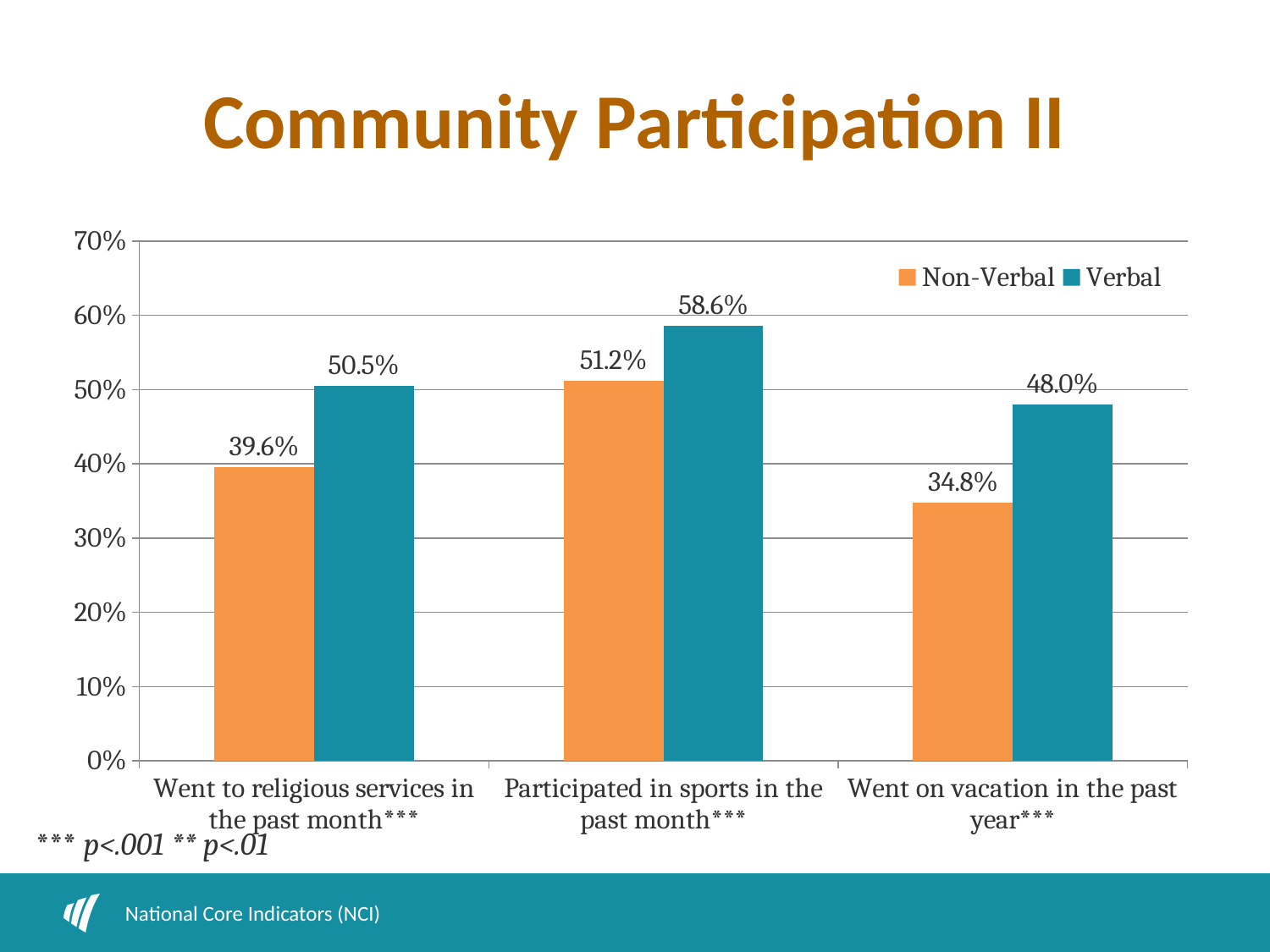
Which category has the highest Verbal value? Participated in sports in the past month What is the Verbal value for 'Participated in sports in the past month'? 58.6% Which is larger for 'Participated in sports in the past month': the Non-Verbal value or the Verbal value? Verbal Is the Non-Verbal value for 'Participated in sports in the past month' greater or less than 50%? greater What is the Verbal value for 'Went on vacation in the past year'? 48.0% What is the Non-Verbal value for 'Went on vacation in the past year'? 34.8% How many categories are shown on the x axis? 3 Which category has the lowest Non-Verbal value? Went on vacation in the past year What is the difference between the Verbal and Non-Verbal values for 'Went to religious services in the past month'? 10.9% How many series does the legend list? 2 What is the Non-Verbal value for 'Went to religious services in the past month'? 39.6% What kind of chart is shown on the slide? Bar chart